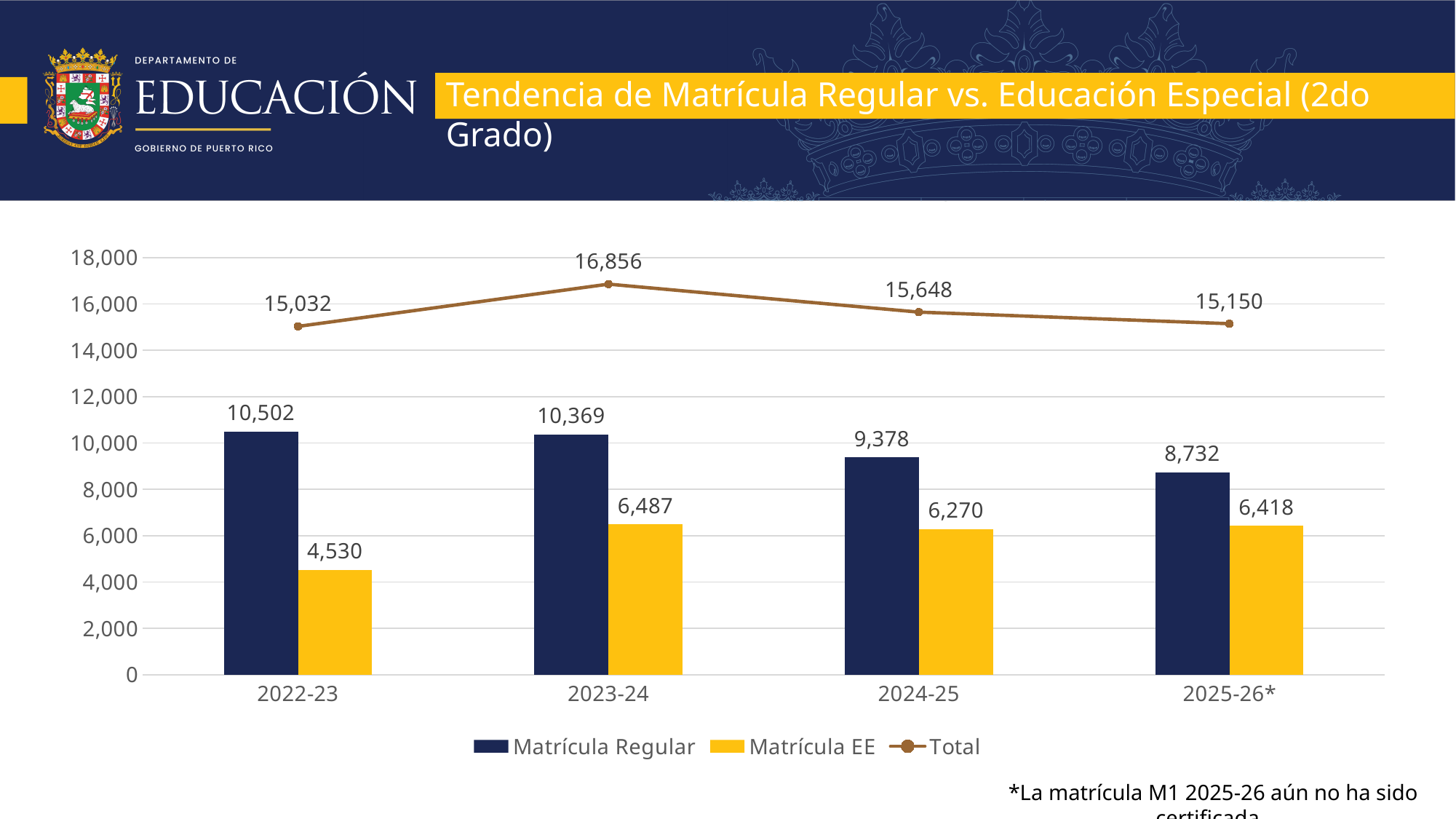
Which year has the highest Total? 2023-24 Which year has the lowest Matrícula EE value? 2022-23 What is the Matrícula Regular value for 2022-23? 10,502 What is the Total value for 2023-24? 16,856 What is the Matrícula EE value for 2024-25? 6,270 What kind of chart is this? Combined bar and line chart How many years are shown on the x axis? 4 Which series is shown in yellow? Matrícula EE What is the difference between Matrícula Regular and Matrícula EE in 2025-26*? 2,314 Which is larger, the Matrícula EE value for 2023-24 or for 2025-26*? 2023-24 Does the Matrícula Regular value rise or fall from 2022-23 to 2025-26*? Fall How many series does the legend list? 3